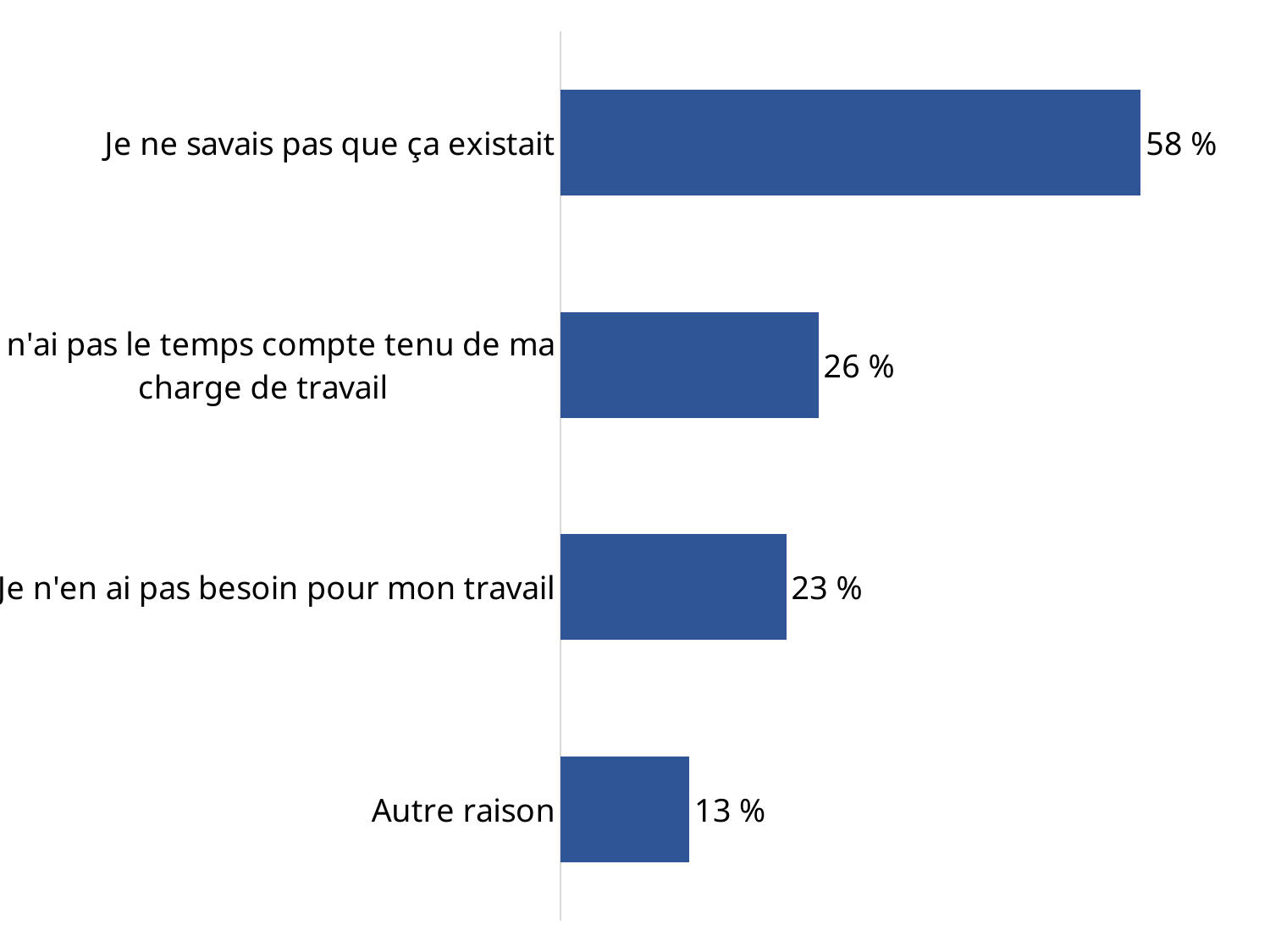
What is the value for "Je n'en ai pas besoin pour mon travail"? 23 % What is the difference between the values for "Je n'en ai pas besoin pour mon travail" and "Autre raison"? 10 % What colour are the bars in the chart? Blue Which category has the lowest value? Autre raison What is the value for "Je ne savais pas que ça existait"? 58 % Which category has the highest value? Je ne savais pas que ça existait Which is larger: the value for "Je n'en ai pas besoin pour mon travail" or the value for "Autre raison"? Je n'en ai pas besoin pour mon travail What is the difference between the values for "Je ne savais pas que ça existait" and "Autre raison"? 45 % How many categories are shown in the chart? 4 What kind of chart is shown on the slide? Bar chart What is the value for the category about not having time given the workload ("...n'ai pas le temps compte tenu de ma charge de travail")? 26 % What is the value for "Autre raison"? 13 %